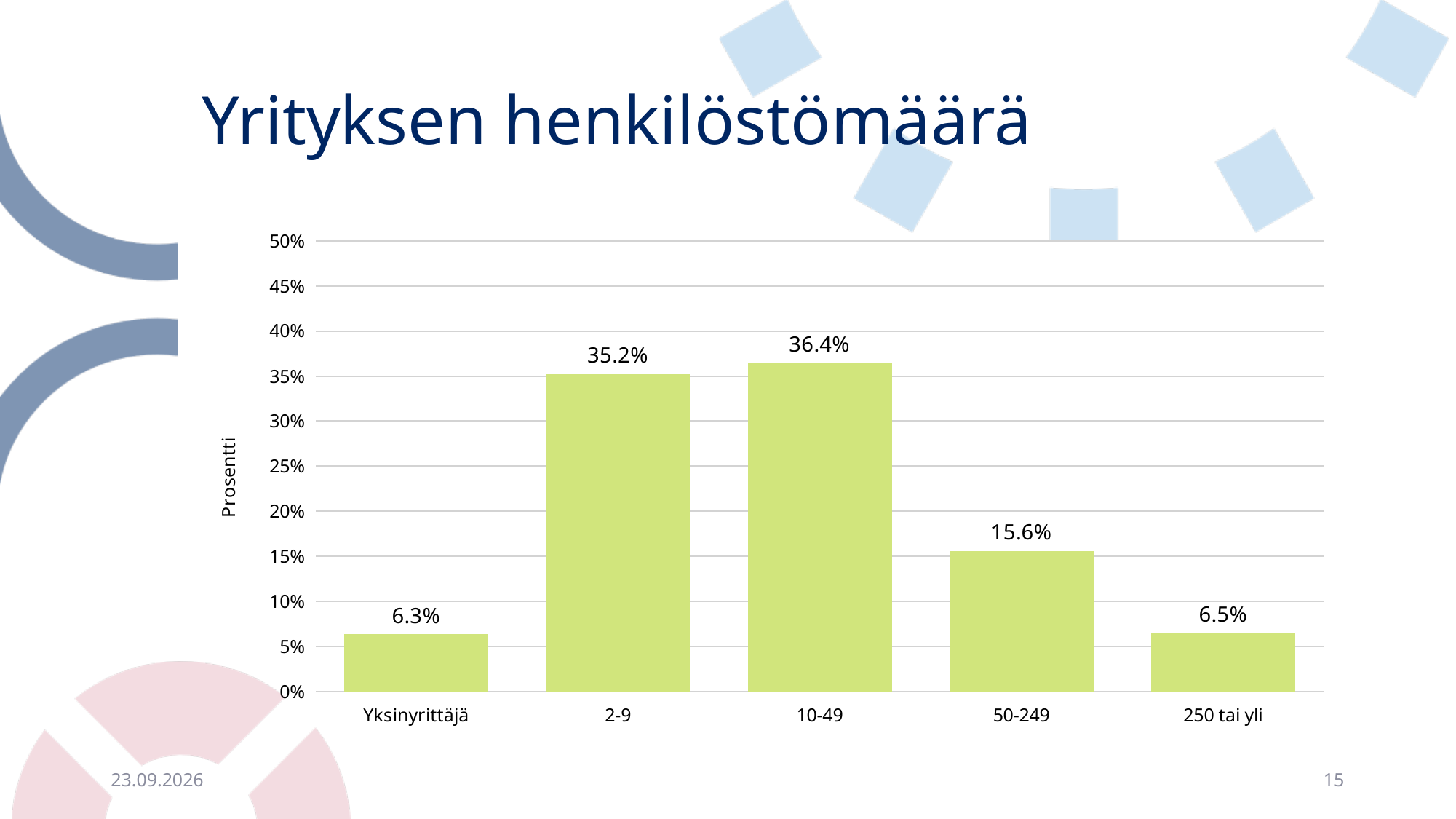
What kind of chart is shown on the slide? bar chart What is the label of the y axis? Prosentti Which category has the lowest value? Yksinyrittäjä What is the difference between the values for 10-49 and 50-249? 20.8% What is the value for 2-9? 35.2% How many categories are shown on the x axis? 5 What is the title of the slide? Yrityksen henkilöstömäärä Is the value for 250 tai yli greater or less than 10%? less What is the value for Yksinyrittäjä? 6.3% Which category has the highest value? 10-49 What is the value for 50-249? 15.6% Which is larger, the value for 2-9 or the value for 50-249? 2-9